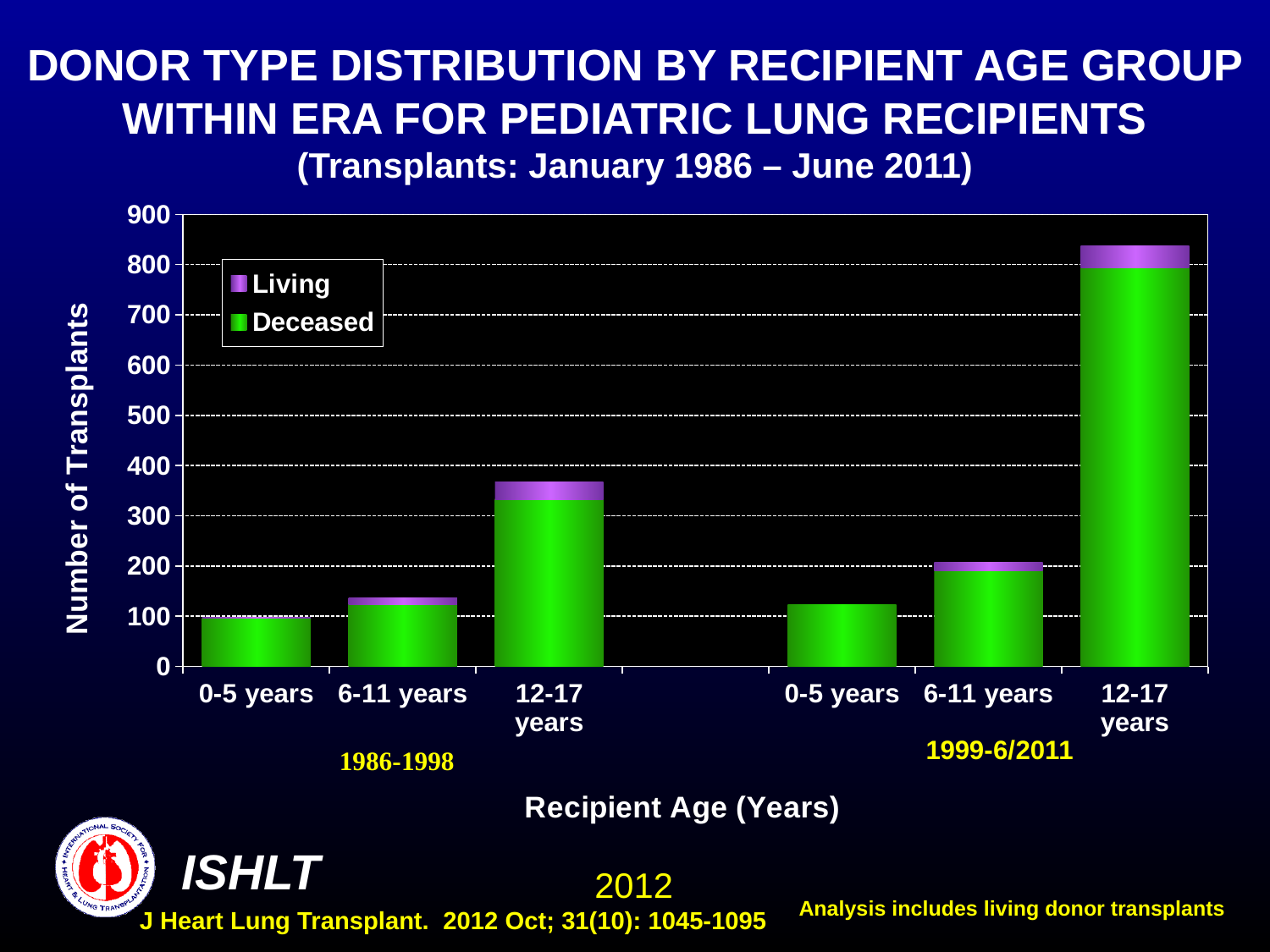
Is the total for 12-17 years in the 1999-6/2011 era greater or less than 800? greater What kind of chart is shown on the slide? Stacked bar chart How many bars are plotted in the chart? 6 Within the 1999-6/2011 era, do the totals rise or fall as recipient age increases? rise Is the total for 12-17 years in the 1986-1998 era greater or less than 300? greater Is the total for 6-11 years in the 1999-6/2011 era greater or less than 300? less Which colour represents the Living donor series in the legend? Purple How many series does the legend list? 2 Which bar has the highest total number of transplants? 12-17 years (1999-6/2011) Which is larger: the total for 12-17 years in 1986-1998 or the total for 12-17 years in 1999-6/2011? 12-17 years in 1999-6/2011 Which bar has the lowest total number of transplants? 0-5 years (1986-1998)